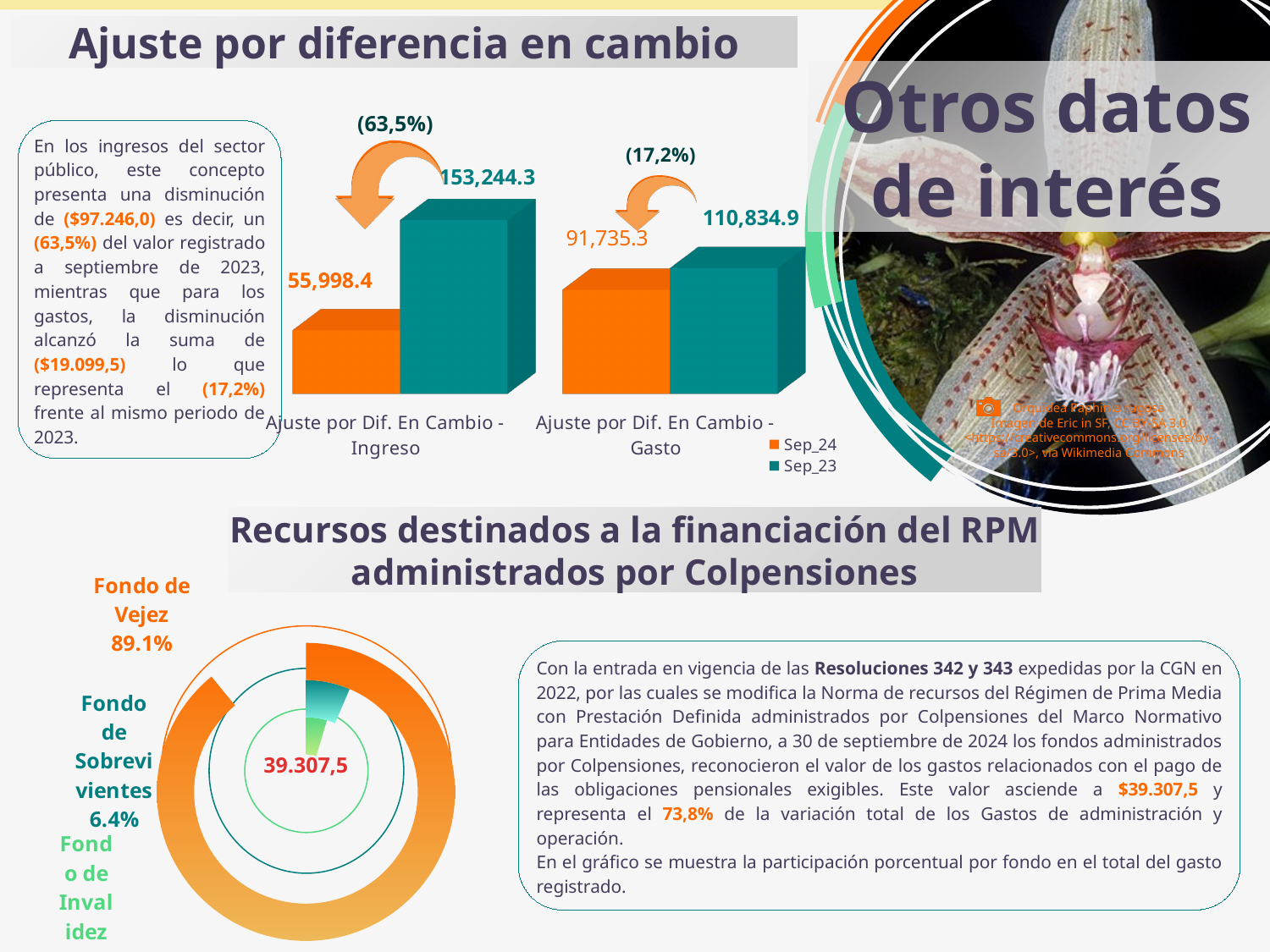
In the 'Ajuste por diferencia en cambio' bar chart, what is the Sep_23 value for Ajuste por Dif. En Cambio - Gasto? 110,834.9 In the 'Ajuste por diferencia en cambio' bar chart, what is the Sep_24 value for Ajuste por Dif. En Cambio - Gasto? 91,735.3 In the 'Recursos destinados a la financiación del RPM administrados por Colpensiones' chart, what share does Fondo de Sobrevivientes have? 6.4% How many series does the legend of the 'Ajuste por diferencia en cambio' chart list? 2 In the 'Ajuste por diferencia en cambio' bar chart, which is larger for Ajuste por Dif. En Cambio - Ingreso: the Sep_24 value or the Sep_23 value? Sep_23 What kind of chart is the 'Ajuste por diferencia en cambio' chart? Bar chart In the 'Ajuste por diferencia en cambio' bar chart, what is the Sep_24 value for Ajuste por Dif. En Cambio - Ingreso? 55,998.4 In the 'Ajuste por diferencia en cambio' bar chart, which bar has the lowest value? Ajuste por Dif. En Cambio - Ingreso, Sep_24 In the 'Recursos destinados a la financiación del RPM administrados por Colpensiones' chart, what share does Fondo de Vejez have? 89.1% In the 'Ajuste por diferencia en cambio' bar chart, what is the Sep_23 value for Ajuste por Dif. En Cambio - Ingreso? 153,244.3 In the 'Ajuste por diferencia en cambio' bar chart, what is the difference between the Sep_23 and Sep_24 values for Ajuste por Dif. En Cambio - Gasto? 19,099.6 In the 'Ajuste por diferencia en cambio' bar chart, which bar has the highest value? Ajuste por Dif. En Cambio - Ingreso, Sep_23